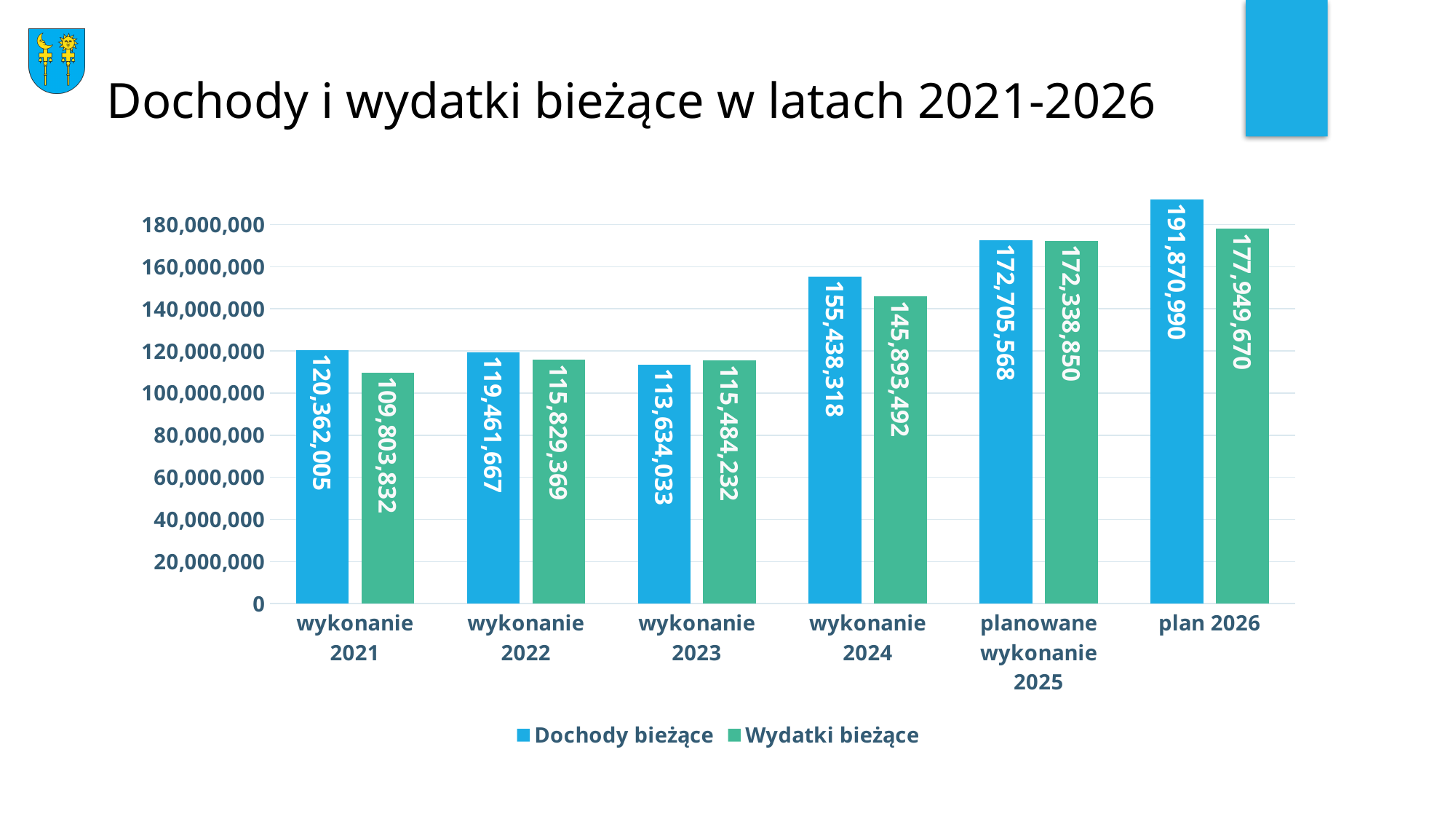
What is the value of Wydatki bieżące for wykonanie 2024? 145,893,492 What is the value of Dochody bieżące for wykonanie 2021? 120,362,005 What is the value of Dochody bieżące for planowane wykonanie 2025? 172,705,568 How many categories are shown on the x axis? 6 How many series does the legend list? 2 Which category has the lowest value of Dochody bieżące? wykonanie 2023 For wykonanie 2023, which is larger: Dochody bieżące or Wydatki bieżące? Wydatki bieżące Which category has the highest value of Dochody bieżące? plan 2026 What type of chart is shown on the slide? bar chart What is the difference between Dochody bieżące and Wydatki bieżące for plan 2026? 13,921,320 Which category has the lowest value of Wydatki bieżące? wykonanie 2021 What is the value of Wydatki bieżące for plan 2026? 177,949,670